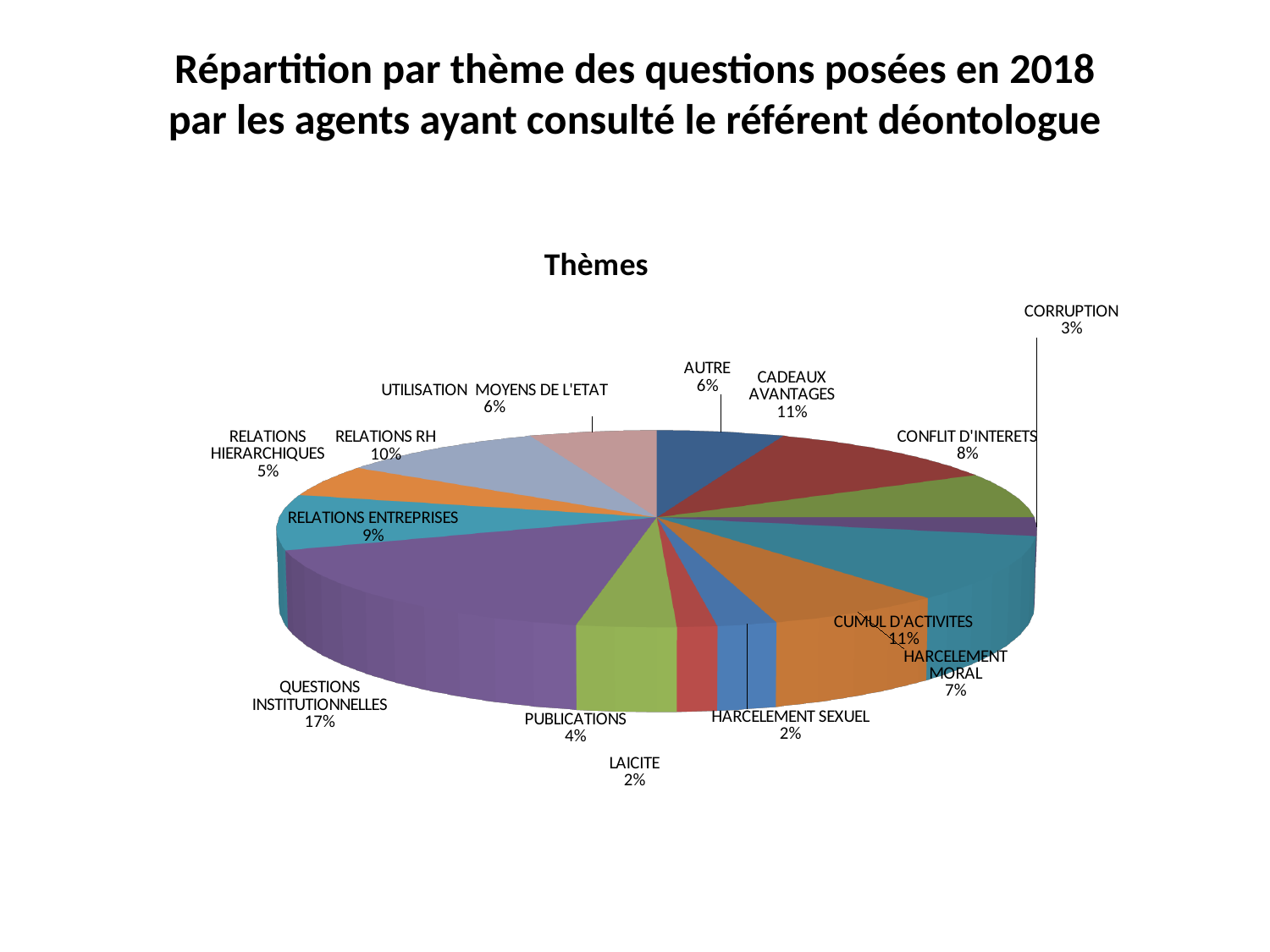
Which has a larger share, CONFLIT D'INTERETS or RELATIONS HIERARCHIQUES? CONFLIT D'INTERETS How many themes (slices) are shown in the pie chart? 14 Which theme has the largest share of the pie? QUESTIONS INSTITUTIONNELLES What is the difference in percentage points between QUESTIONS INSTITUTIONNELLES and RELATIONS ENTREPRISES? 8 What is the title of the chart? Thèmes What share of the pie does QUESTIONS INSTITUTIONNELLES represent? 17% What kind of chart is shown on the slide? pie chart What percentage is shown for CADEAUX AVANTAGES? 11% What percentage is shown for RELATIONS RH? 10% What percentage is shown for UTILISATION MOYENS DE L'ETAT? 6% What percentage is shown for HARCELEMENT MORAL? 7% What percentage is shown for CORRUPTION? 3%